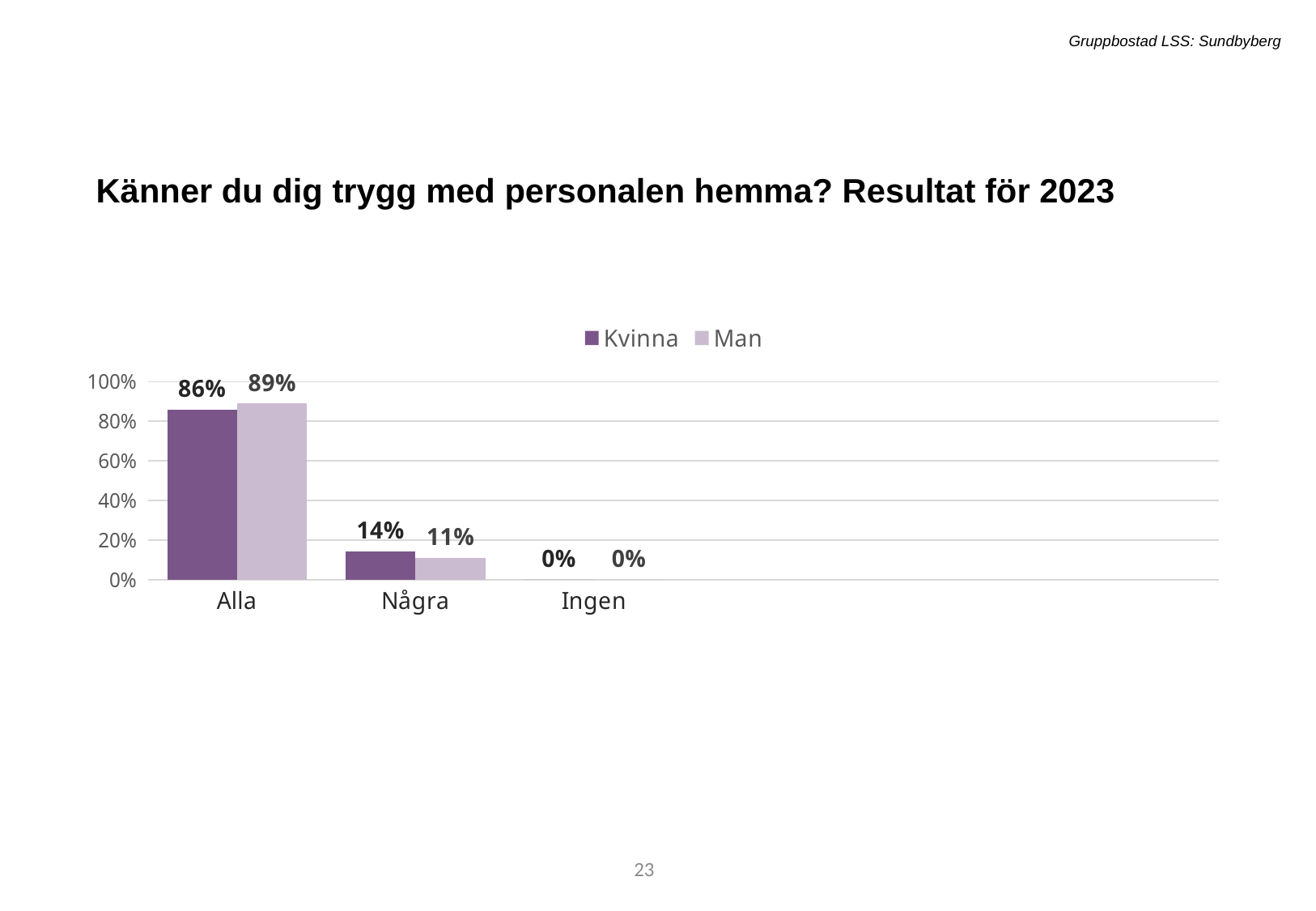
Which category has the lowest value for the Man series? Ingen What is the value for Kvinna in the Alla category? 86% What is the value for Man in the Ingen category? 0% What kind of chart is shown on the slide? Bar chart How many categories are shown on the x axis? 3 What is the value for Man in the Alla category? 89% How many series does the legend list? 2 What are the two series named in the legend? Kvinna and Man Which category has the highest value for the Kvinna series? Alla What is the difference between the Man and Kvinna values in the Alla category? 3% What is the value for Kvinna in the Några category? 14% In the Några category, which series has the larger value, Kvinna or Man? Kvinna